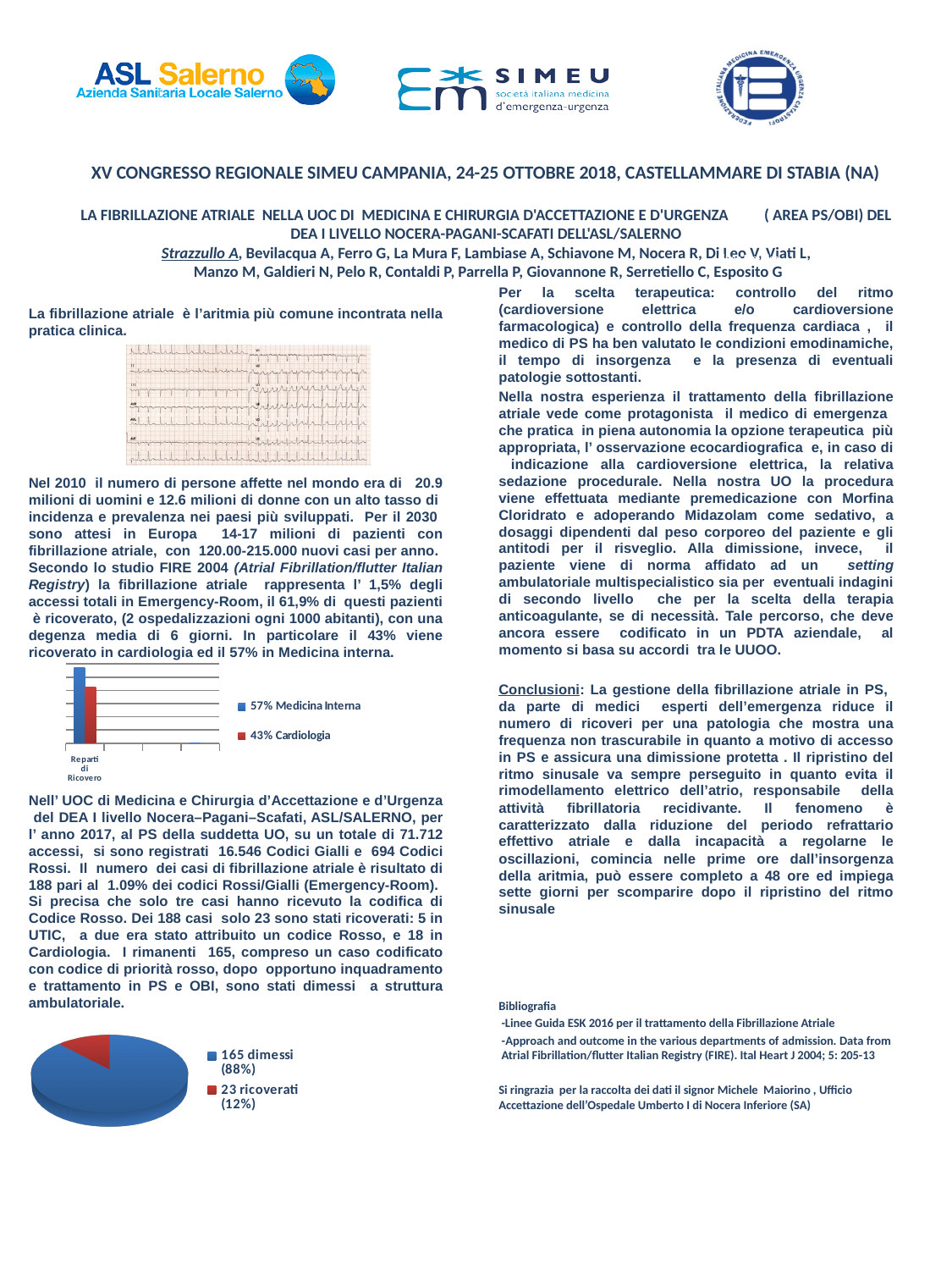
In the bar chart labelled 'Reparti di Ricovero', which series has the taller bar, Medicina Interna or Cardiologia? Medicina Interna In the bar chart labelled 'Reparti di Ricovero', what percentage is shown for Cardiologia? 43% In the bar chart labelled 'Reparti di Ricovero', what percentage is shown for Medicina Interna? 57% In the pie chart at the bottom left of the slide, which slice is larger, 'dimessi' or 'ricoverati'? dimessi In the bar chart labelled 'Reparti di Ricovero', what is the difference in percentage points between Medicina Interna and Cardiologia? 14 In the bar chart labelled 'Reparti di Ricovero', how many series does the legend list? 2 What kind of chart is the chart at the bottom left of the slide showing 'dimessi' and 'ricoverati'? pie chart In the pie chart at the bottom left of the slide, how many patients were 'ricoverati'? 23 In the pie chart at the bottom left of the slide, what share of the pie do the 'dimessi' represent? 88% What kind of chart is the chart labelled 'Reparti di Ricovero' on the left of the slide? bar chart In the pie chart at the bottom left of the slide, how many slices are there? 2 In the pie chart at the bottom left of the slide, how many patients were 'dimessi'? 165